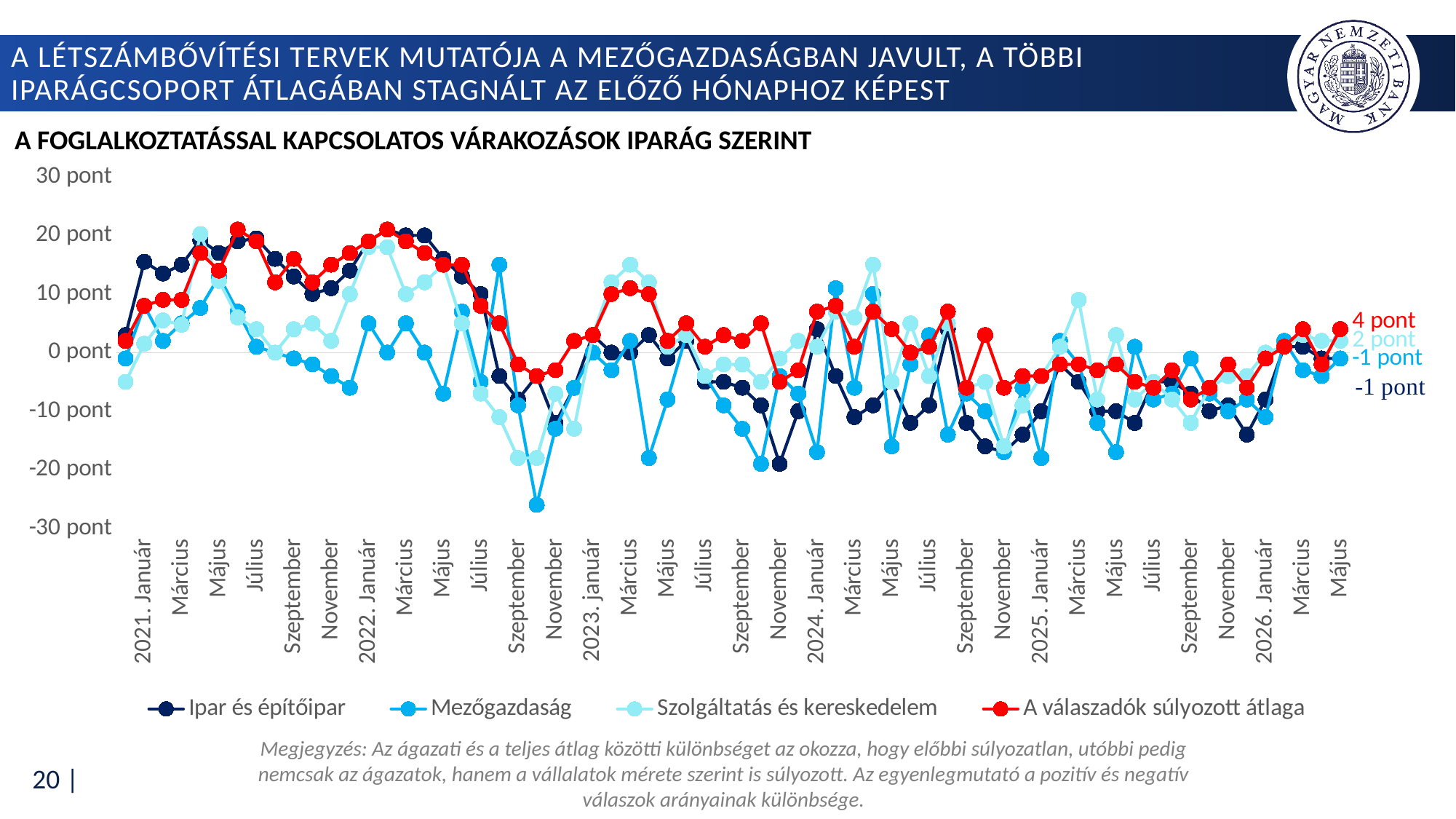
What is the latest value shown for A válaszadók súlyozott átlaga? 4 pont Which series reaches the lowest value anywhere on the chart? Mezőgazdaság What is the latest value shown for Ipar és építőipar? -1 pont What is the latest value shown for Mezőgazdaság? -1 pont How many series does the legend list? 4 What kind of chart is shown on the slide? line chart At the last data point, what is the difference between A válaszadók súlyozott átlaga and Szolgáltatás és kereskedelem? 2 pont At the last data point, which is higher: A válaszadók súlyozott átlaga or Mezőgazdaság? A válaszadók súlyozott átlaga What is the latest value shown for Szolgáltatás és kereskedelem? 2 pont Is the lowest value reached by Mezőgazdaság greater or less than -20 pont? less Does A válaszadók súlyozott átlaga rise or fall between 2022 March and 2022 September? fall What is the title of the chart? A FOGLALKOZTATÁSSAL KAPCSOLATOS VÁRAKOZÁSOK IPARÁG SZERINT